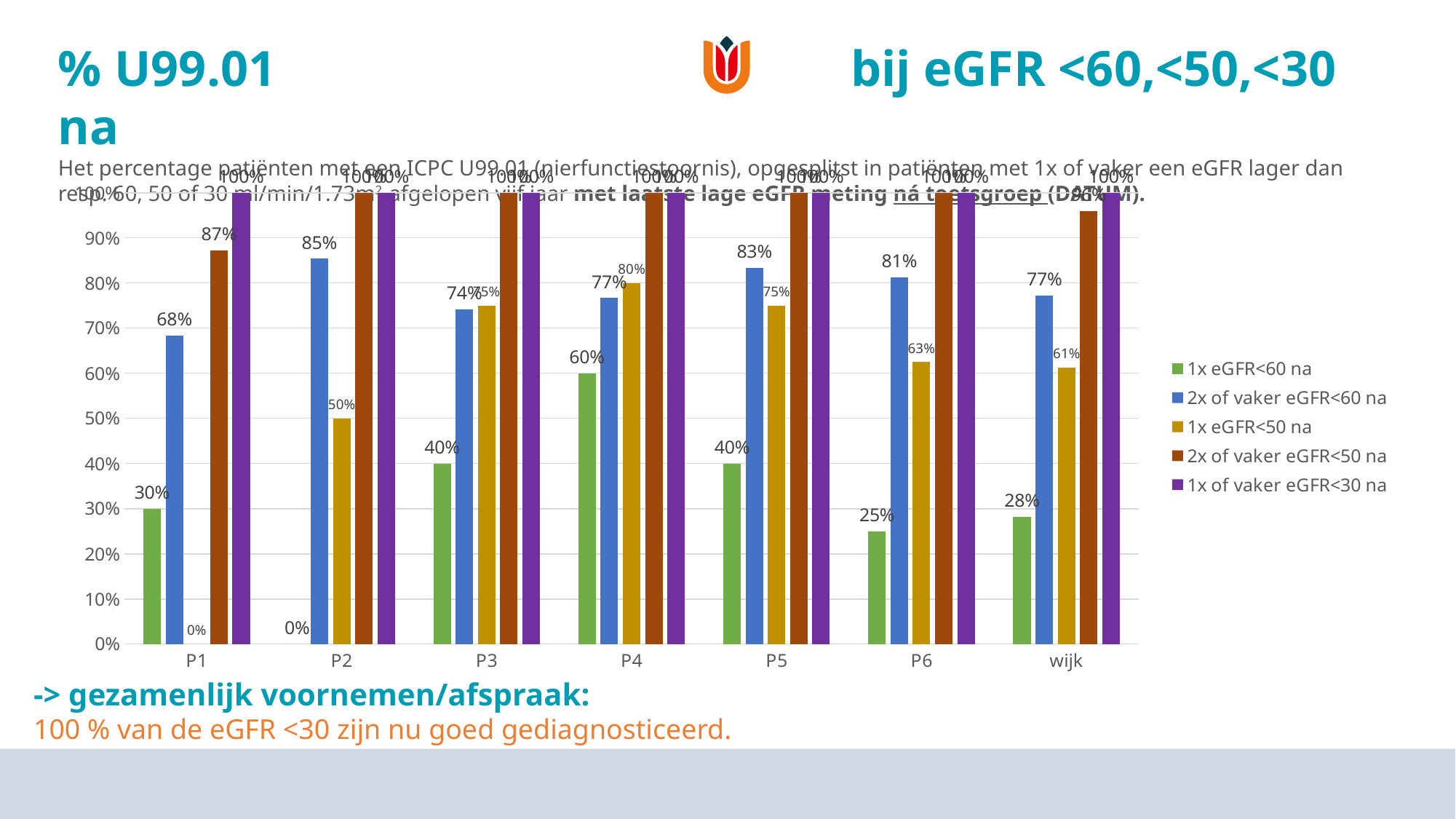
Which category has the lowest value in the '2x of vaker eGFR<60 na' series? P1 What is the value for P6 in the '1x eGFR<50 na' series? 63% Which is larger: the '1x eGFR<60 na' value for P6 or for wijk? wijk What is the value for P1 in the '2x of vaker eGFR<60 na' series? 68% What kind of chart is shown on the slide? bar chart What is the value for P4 in the '1x eGFR<60 na' series? 60% Is the value for P2 in the '1x eGFR<50 na' series greater or less than 60%? less What is the difference between the '2x of vaker eGFR<60 na' values for P2 and P1? 17% Which category has the highest value in the '1x eGFR<60 na' series? P4 How many categories are shown on the x axis? 7 How many series does the legend list? 5 What is the value for P1 in the '2x of vaker eGFR<50 na' series? 87%